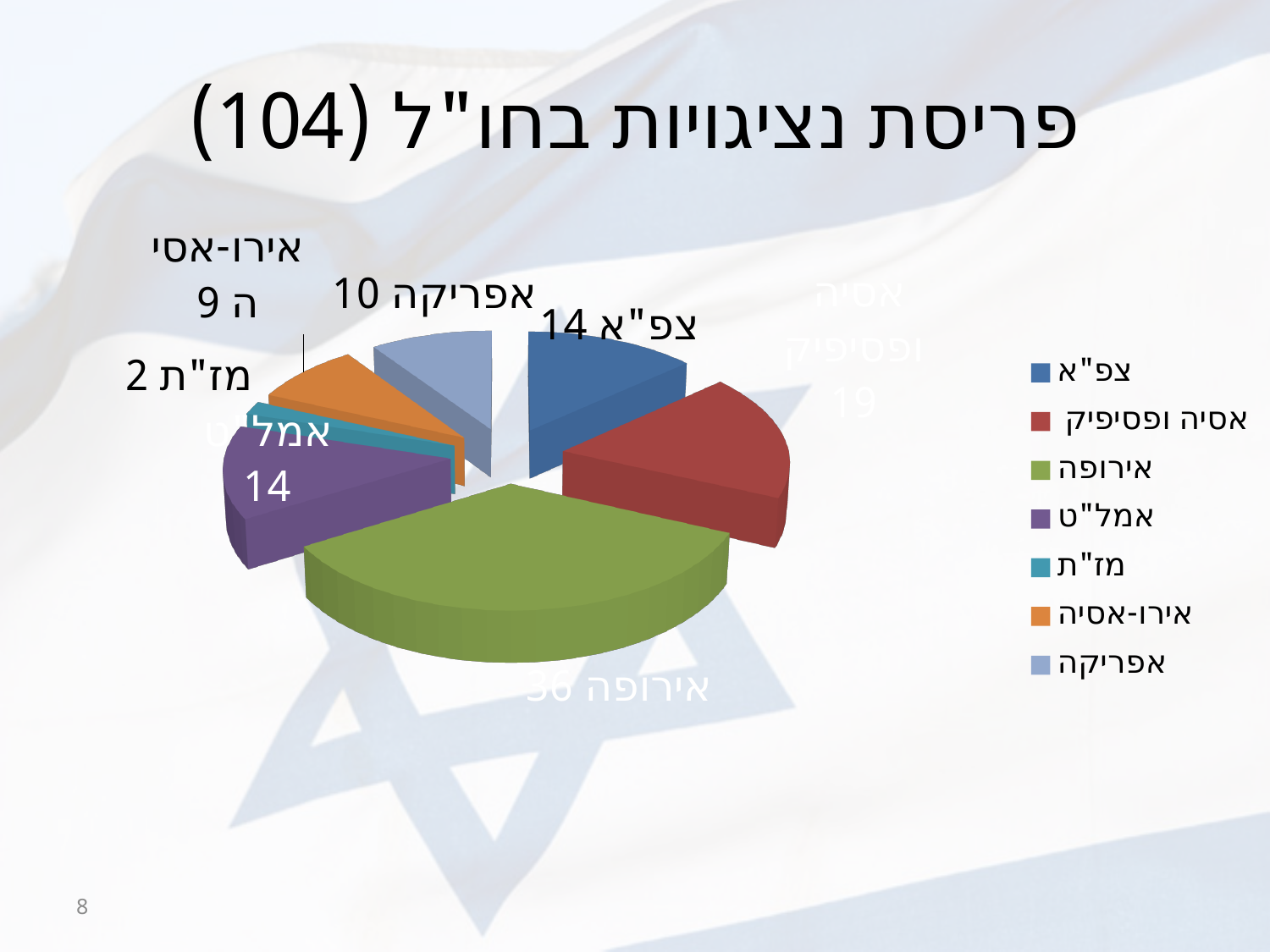
Which category has the largest slice in the pie chart? אירופה What is the difference between the values for אפריקה and אירו-אסיה? 1 What value is shown for צפ"א in the pie chart? 14 Which is larger, the value for אפריקה or the value for אירו-אסיה? אפריקה What value is shown for אמל"ט in the pie chart? 14 What value is shown for מז"ת in the pie chart? 2 What value is shown for אירו-אסיה in the pie chart? 9 What value is shown for אפריקה in the pie chart? 10 How many categories does the legend of the pie chart list? 7 Which category has the smallest slice in the pie chart? מז"ת What value is shown for אירופה in the pie chart? 36 What type of chart is shown on the slide? Pie chart